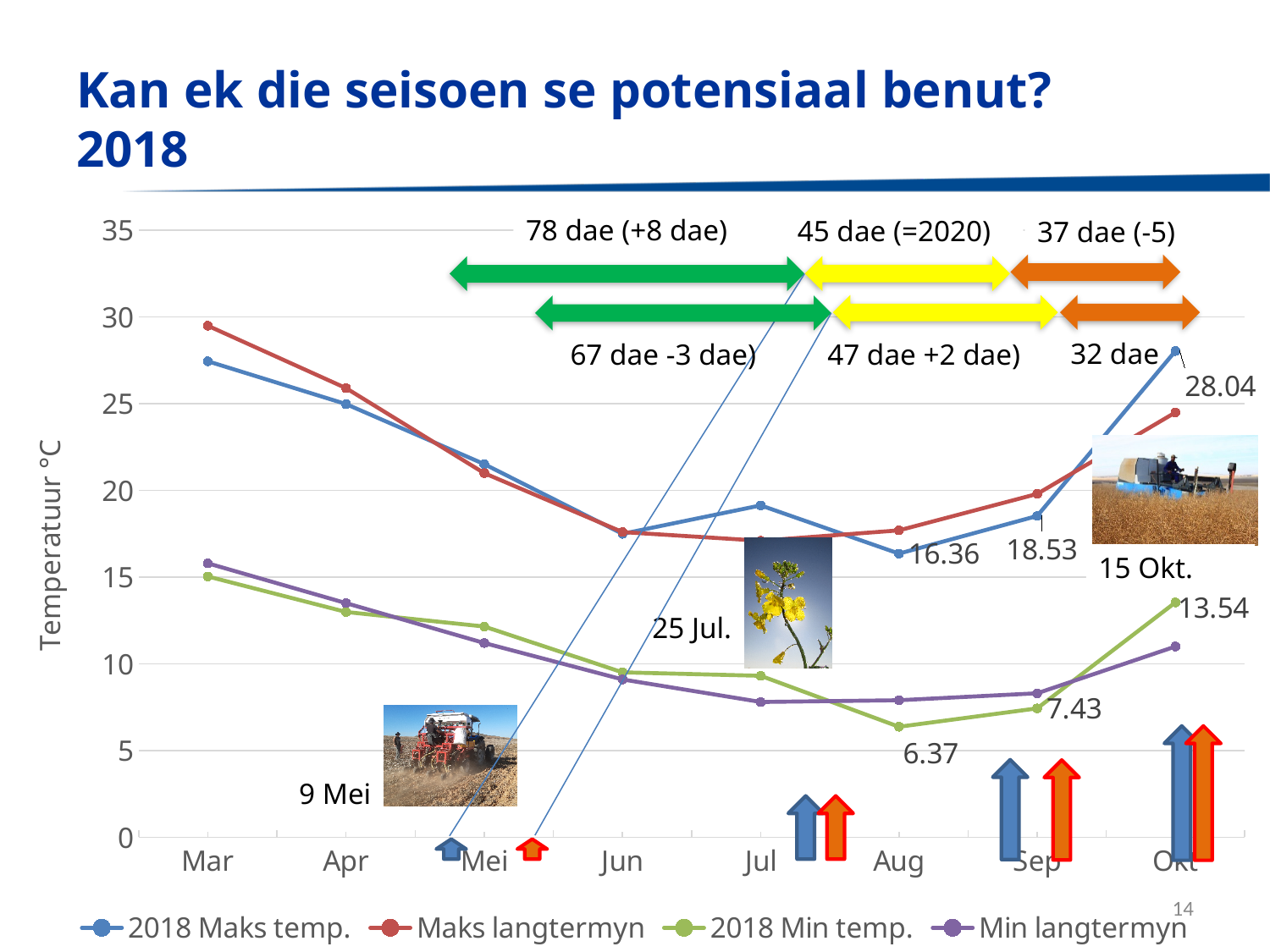
What kind of chart is shown on the slide? line chart What is the value of 2018 Min temp. in Okt? 13.54 In Mar, which is higher: Maks langtermyn or 2018 Maks temp.? Maks langtermyn How many series does the legend list? 4 What is the value of 2018 Maks temp. in Okt? 28.04 What is the difference between the 2018 Maks temp. values for Okt and Sep? 9.51 In which month is 2018 Min temp. lowest? Aug What is the value of 2018 Min temp. in Aug? 6.37 Is the value for Maks langtermyn in Mar greater or less than 25? greater How many months are shown on the x axis? 8 Does 2018 Maks temp. rise or fall from Mar to Jun? fall What is the value of 2018 Maks temp. in Aug? 16.36